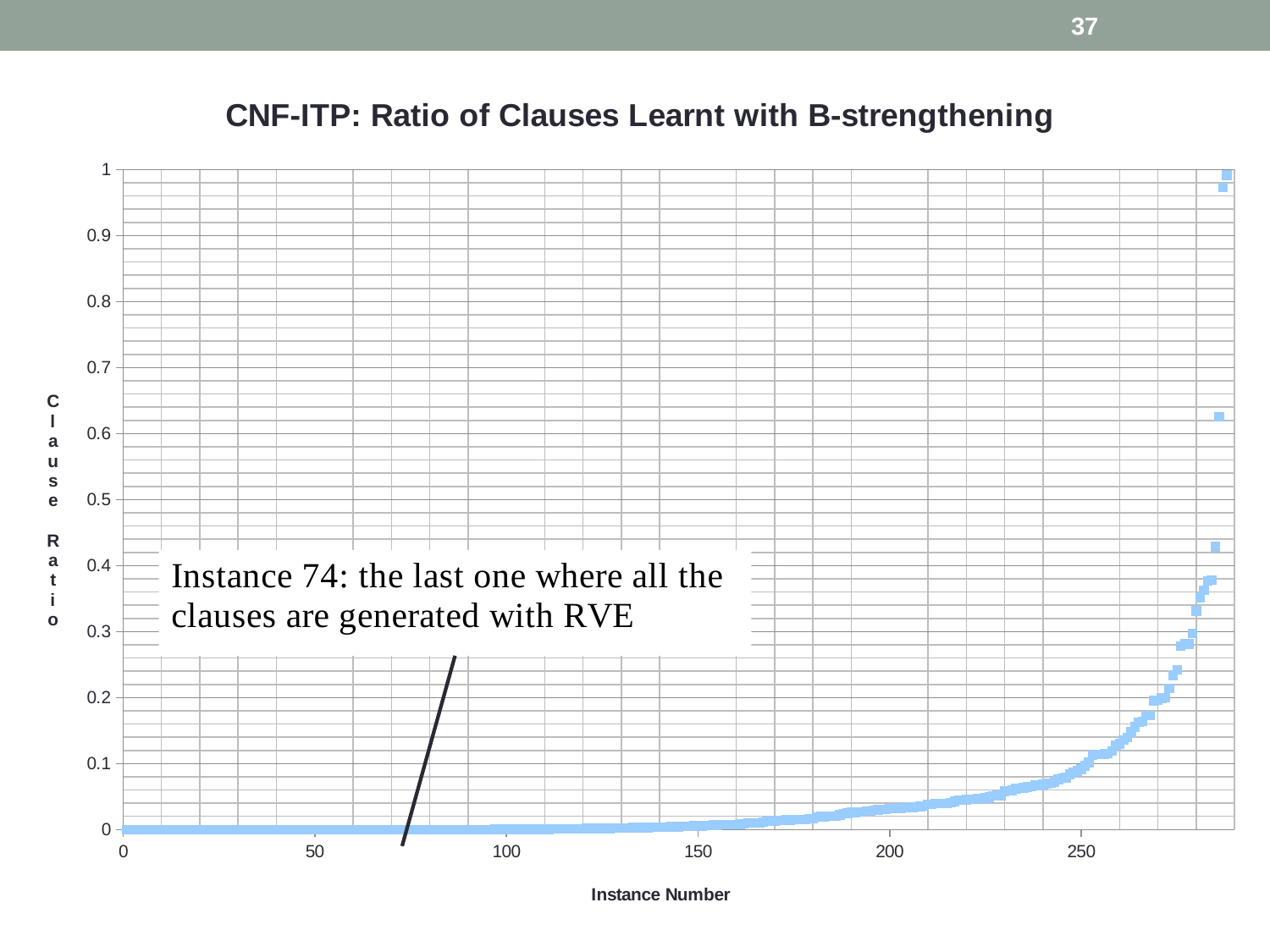
Which is larger, the clause ratio at instance number 100 or at instance number 250? instance number 250 What is the title of the chart? CNF-ITP: Ratio of Clauses Learnt with B-strengthening Is the clause ratio at instance number 100 greater or less than 0.1? less What kind of chart is shown on the slide? scatter plot According to the annotation on the chart, which instance is the last one where all the clauses are generated with RVE? Instance 74 Is the highest plotted clause ratio greater or less than 0.9? greater Is the clause ratio at instance number 50 greater or less than 0.1? less Do the plotted clause ratio values rise or fall as the instance number increases along the x axis? rise Which is larger, the clause ratio at instance number 200 or at instance number 50? instance number 200